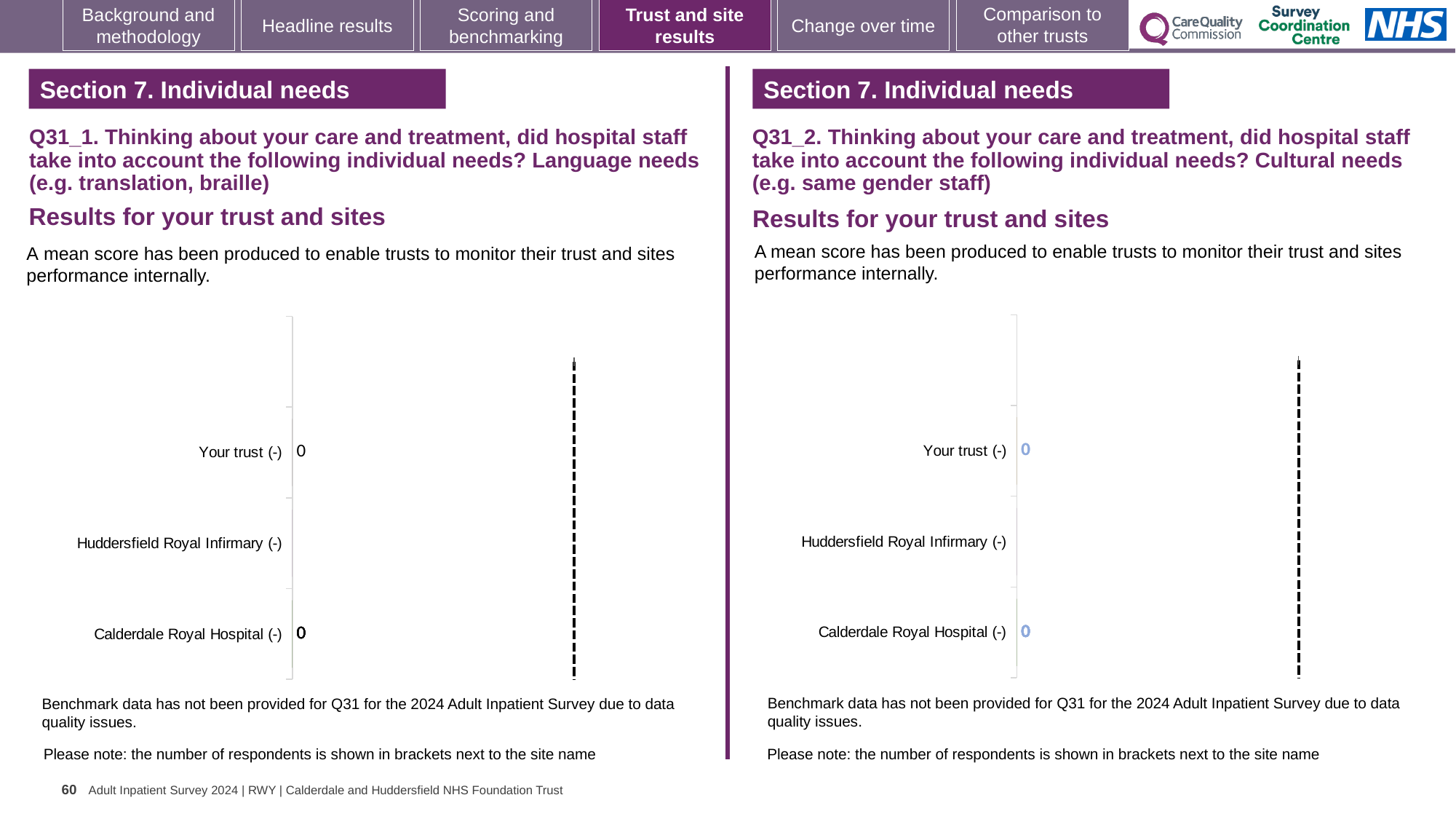
How many categories are listed on the left chart (Q31_1, Language needs)? 3 How many categories are listed on the right chart (Q31_2, Cultural needs)? 3 On the right chart (Q31_2, Cultural needs), what value is shown for Calderdale Royal Hospital? 0 On the right chart (Q31_2, Cultural needs), what value is shown for Your trust? 0 On the left chart (Q31_1, Language needs), what value is shown for Your trust? 0 On the left chart (Q31_1, Language needs), what is the difference between the values for Your trust and Calderdale Royal Hospital? 0 On the left chart (Q31_1, Language needs), what value is shown for Calderdale Royal Hospital? 0 On the right chart (Q31_2, Cultural needs), which category is listed between Your trust and Calderdale Royal Hospital? Huddersfield Royal Infirmary (-) According to the note below the left chart, why has benchmark data not been provided for Q31? Due to data quality issues What kind of chart is the left chart (Q31_1, Language needs)? Bar chart